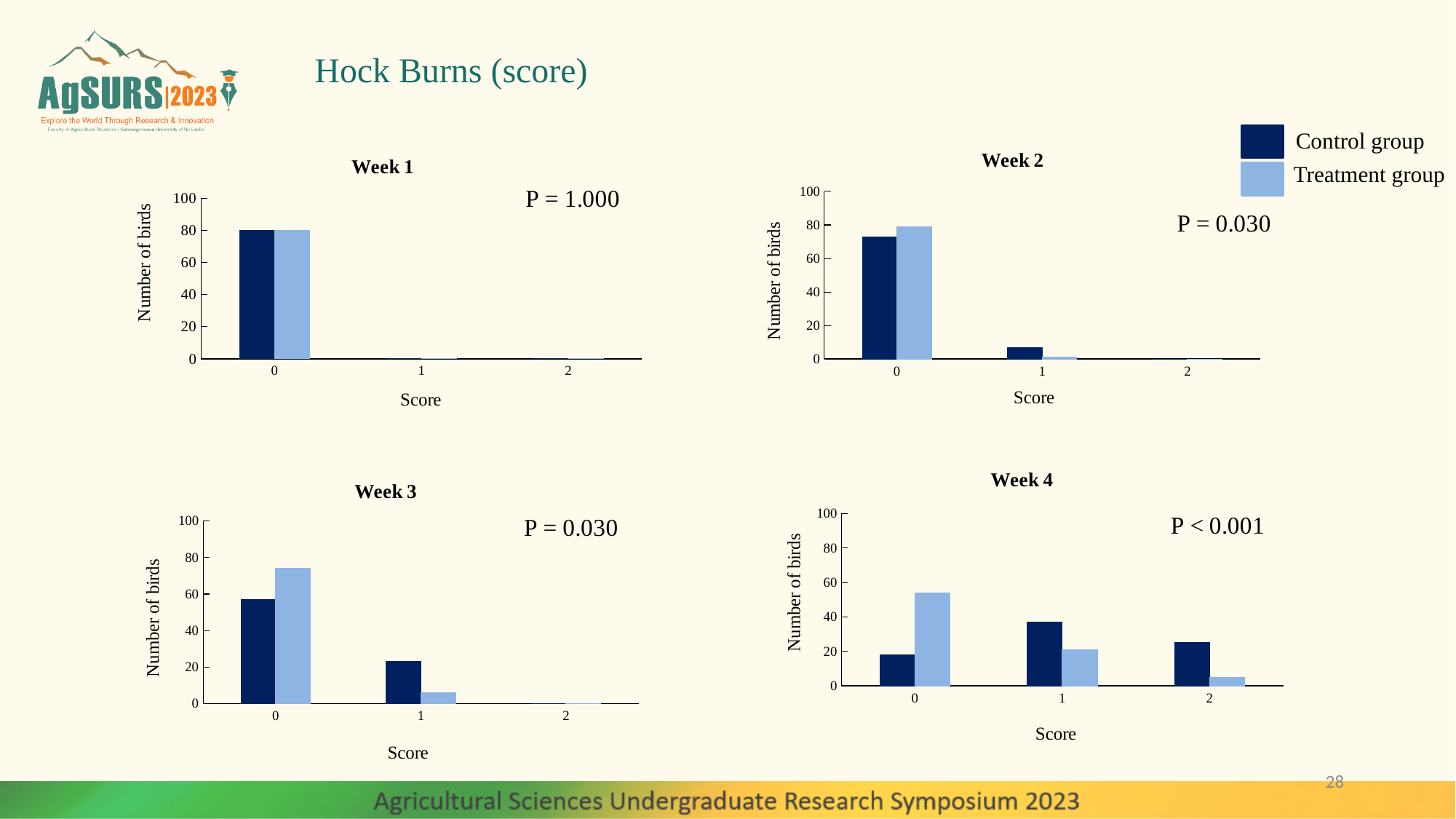
In the Week 4 chart, do the Treatment group values rise or fall as the score increases from 0 to 2? fall In the Week 3 chart, is the value for the Control group at score 1 greater or less than 40? less In the Week 4 chart, at which score is the Control group bar highest? 1 In the Week 4 chart, is the value for the Treatment group at score 2 greater or less than 20? less How many series does the legend list? 2 In the Week 1 chart, what is the number of birds for the Control group at score 0? 80 In the Week 4 chart, is the value for the Treatment group at score 0 greater or less than 40? greater In the Week 2 chart, which group has the larger value at score 1, Control group or Treatment group? Control group What kind of chart is the Week 1 chart? bar chart In the Week 3 chart, which group has the larger value at score 0? Treatment group How many score categories are shown on the x axis of the Week 4 chart? 3